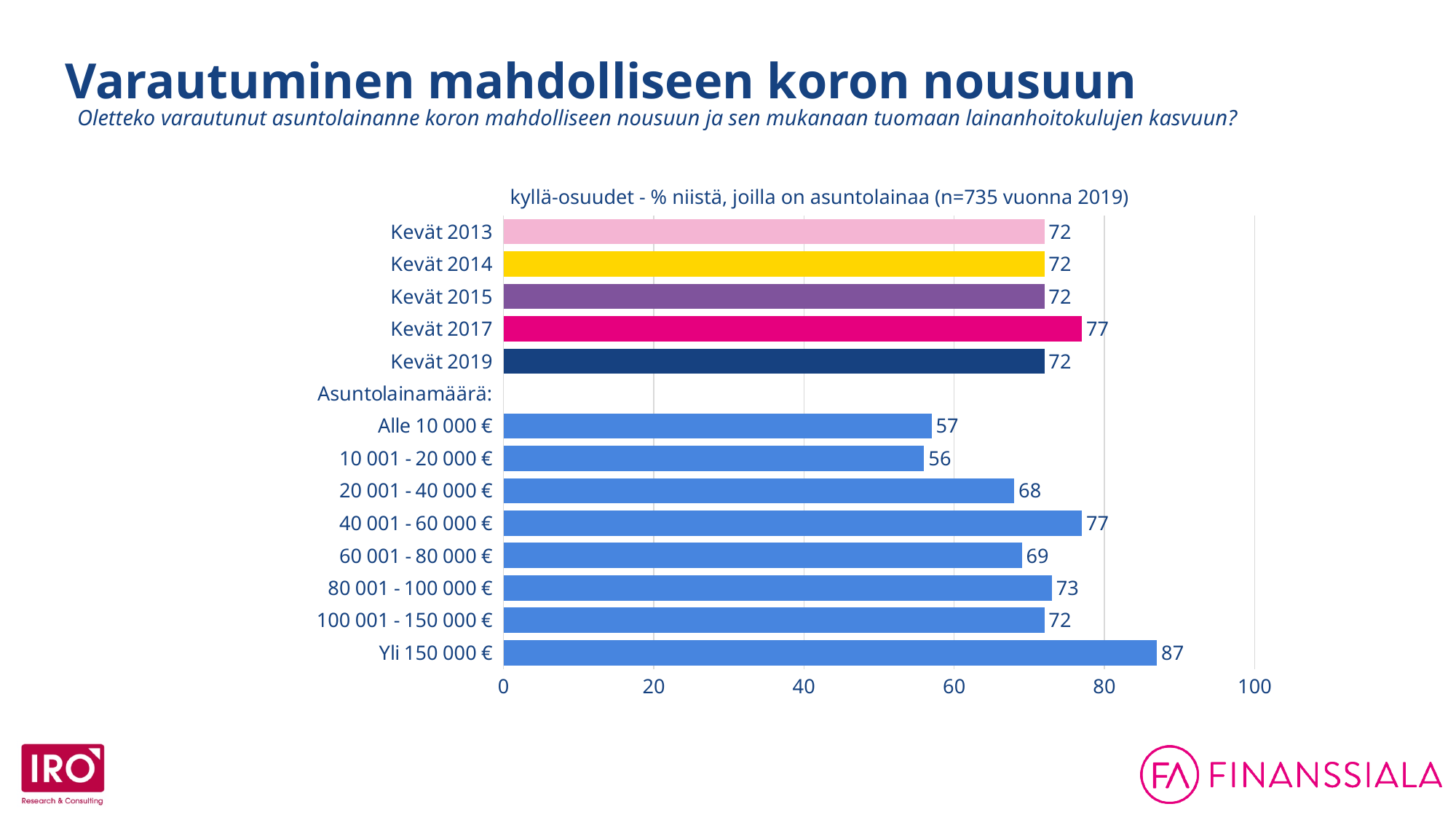
Is the value for 40 001 - 60 000 € greater or less than 60? greater What is the value for Kevät 2017? 77 What is the chart's title? kyllä-osuudet - % niistä, joilla on asuntolainaa (n=735 vuonna 2019) Which category has the lowest value in the chart? 10 001 - 20 000 € What is the value for 60 001 - 80 000 €? 69 Which is larger, the value for 20 001 - 40 000 € or the value for 80 001 - 100 000 €? 80 001 - 100 000 € What is the difference between the values for Yli 150 000 € and Alle 10 000 €? 30 Which category has the highest value in the chart? Yli 150 000 € What is the value for 10 001 - 20 000 €? 56 What is the value for Yli 150 000 €? 87 What is the difference between the values for Kevät 2017 and Kevät 2019? 5 What kind of chart is shown on the slide? bar chart